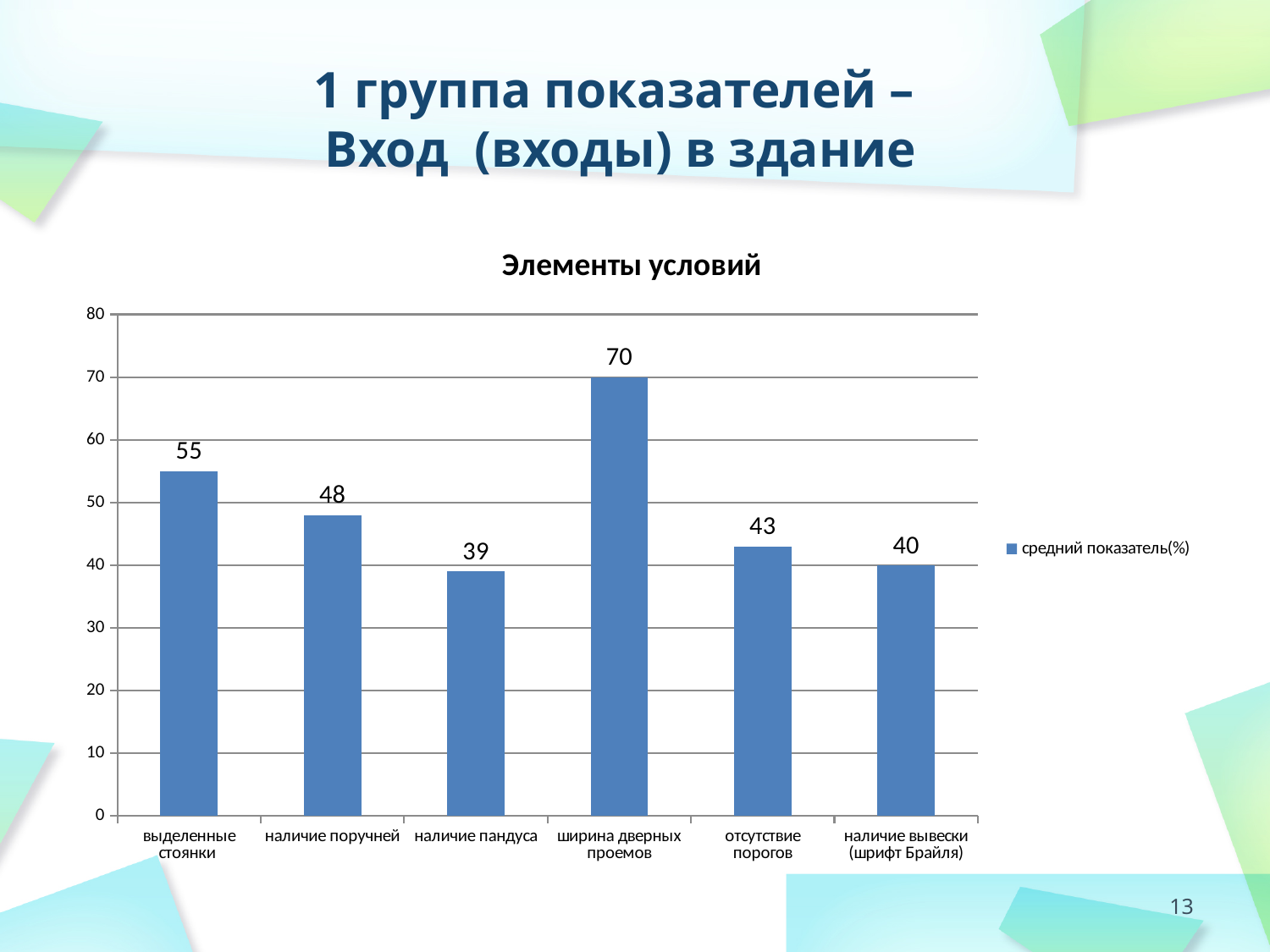
How many categories are shown on the x axis? 6 Is the value for "отсутствие порогов" greater or less than 50? less What is the value for "выделенные стоянки"? 55 Which category has the highest value? ширина дверных проемов What is the difference between the values for "ширина дверных проемов" and "наличие пандуса"? 31 How many series does the legend list? 1 What kind of chart is shown? bar chart Which is larger, the value for "наличие поручней" or the value for "отсутствие порогов"? наличие поручней What is the value for "ширина дверных проемов"? 70 Which category has the lowest value? наличие пандуса What is the value for "наличие вывески (шрифт Брайля)"? 40 What is the title of the chart? Элементы условий